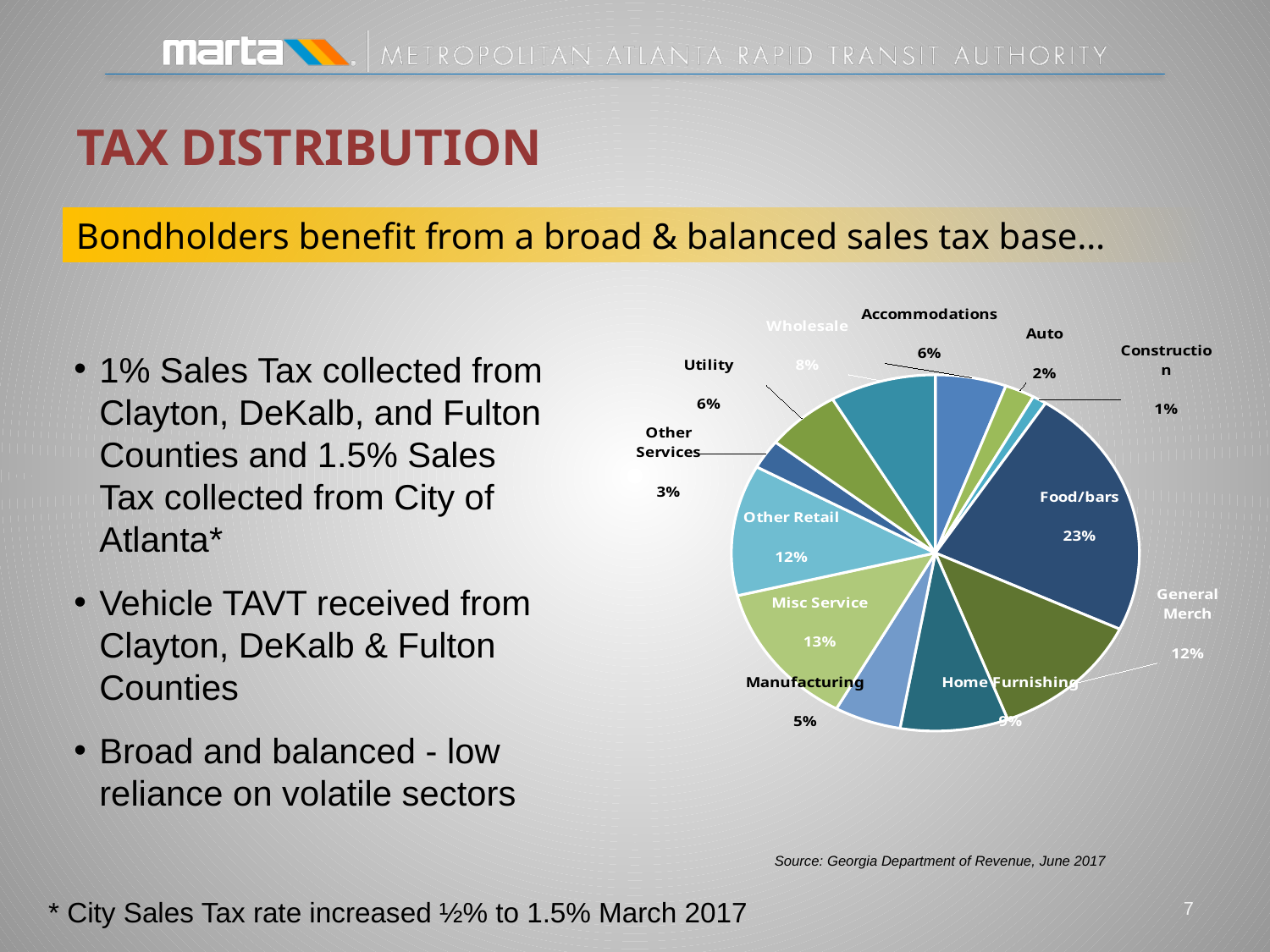
What percentage is shown for Construction? 1% Which category has the largest share of the pie? Food/bars What source is cited below the chart? Georgia Department of Revenue, June 2017 Which category has the smallest share of the pie? Construction What share of the pie does Food/bars account for? 23% What percentage is shown for Wholesale? 8% How many categories are shown in the pie chart? 12 Which is larger, the share for Manufacturing or the share for Utility? Utility What percentage is shown for Misc Service? 13% What type of chart is shown on the slide? Pie chart What is the difference in percentage points between Food/bars and Misc Service? 10 What percentage is shown for Other Retail? 12%